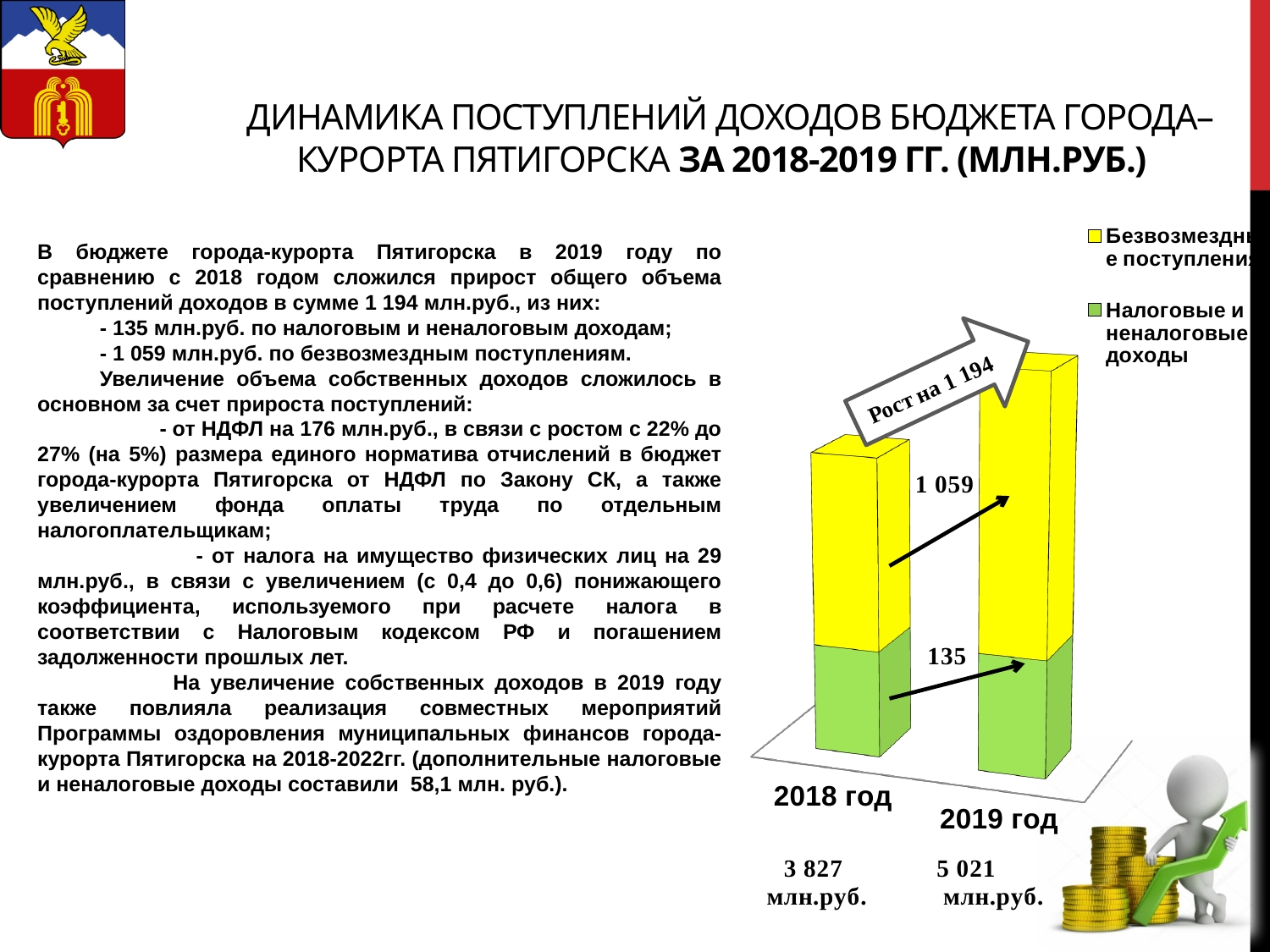
What growth figure is written on the large arrow above the bars? Рост на 1 194 How many series does the chart legend list? 2 Which series is shown in yellow in the legend? Безвозмездные поступления What total value is shown for 2019 год? 5 021 млн.руб. What kind of chart is shown on the slide? Stacked bar chart How many years (categories) are shown on the chart? 2 What increase is labelled on the arrow pointing to the green (Налоговые и неналоговые доходы) segment? 135 What total value is shown for 2018 год? 3 827 млн.руб. By how much does the total for 2019 год exceed the total for 2018 год? 1 194 Do the bar totals rise or fall from 2018 год to 2019 год? Rise What increase is labelled on the arrow pointing to the yellow (Безвозмездные поступления) segment? 1 059 Which year has the higher total bar, 2018 год or 2019 год? 2019 год